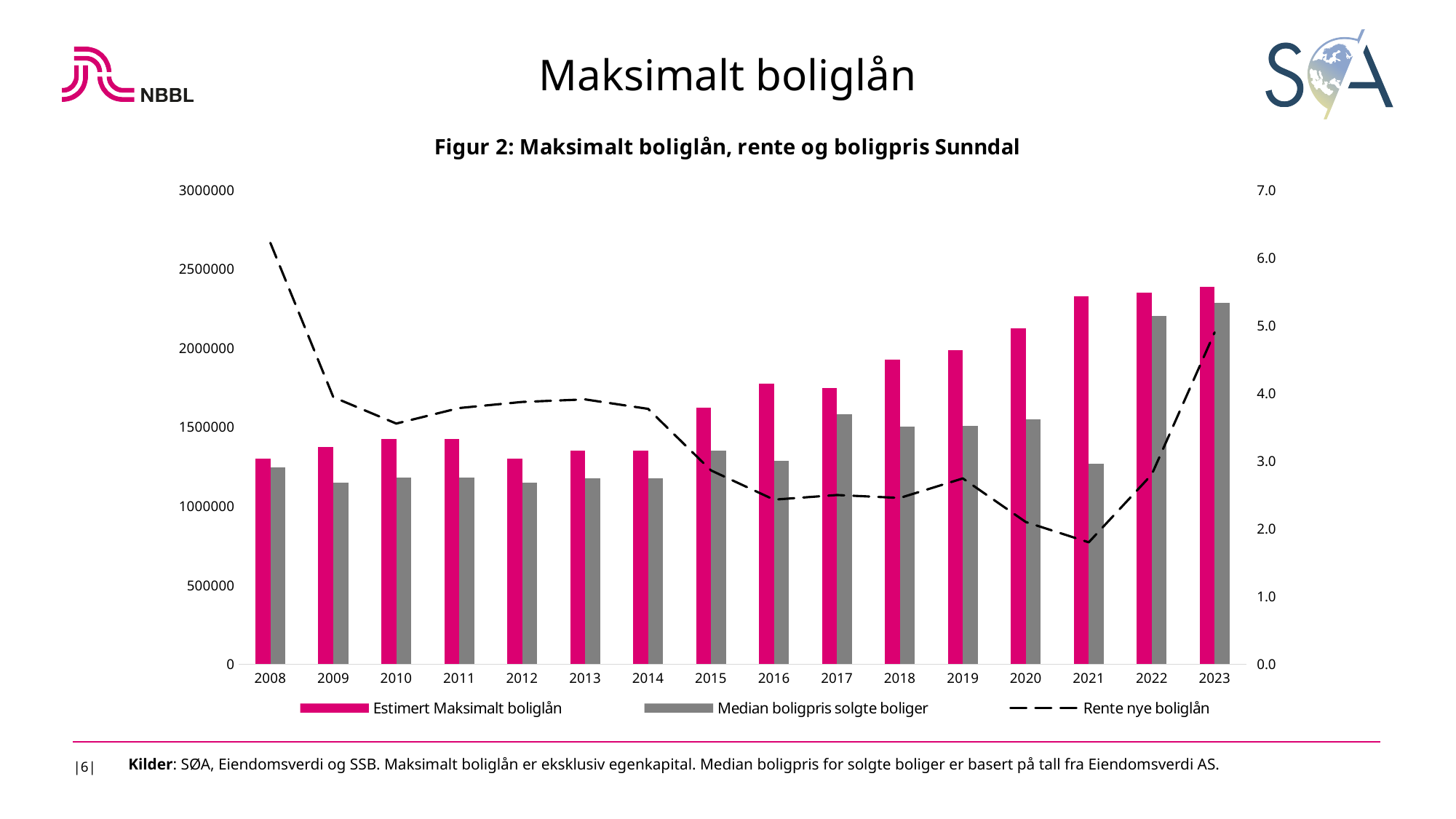
Which year has the highest value for Rente nye boliglån? 2008 Is the value for Rente nye boliglån in 2008 greater or less than 6.0? greater Which year has the lowest value for Rente nye boliglån? 2021 Which series is drawn as a dashed line? Rente nye boliglån Is the value for Estimert Maksimalt boliglån in 2020 greater or less than 2000000? greater In 2021, which is larger: Estimert Maksimalt boliglån or Median boligpris solgte boliger? Estimert Maksimalt boliglån Is the value for Rente nye boliglån in 2021 greater or less than 2.0? less How many series does the legend list? 3 How many years are shown on the x axis? 16 What type of chart is shown in Figur 2? A bar chart combined with a dashed line Does Estimert Maksimalt boliglån generally rise or fall from 2008 to 2023? Rise